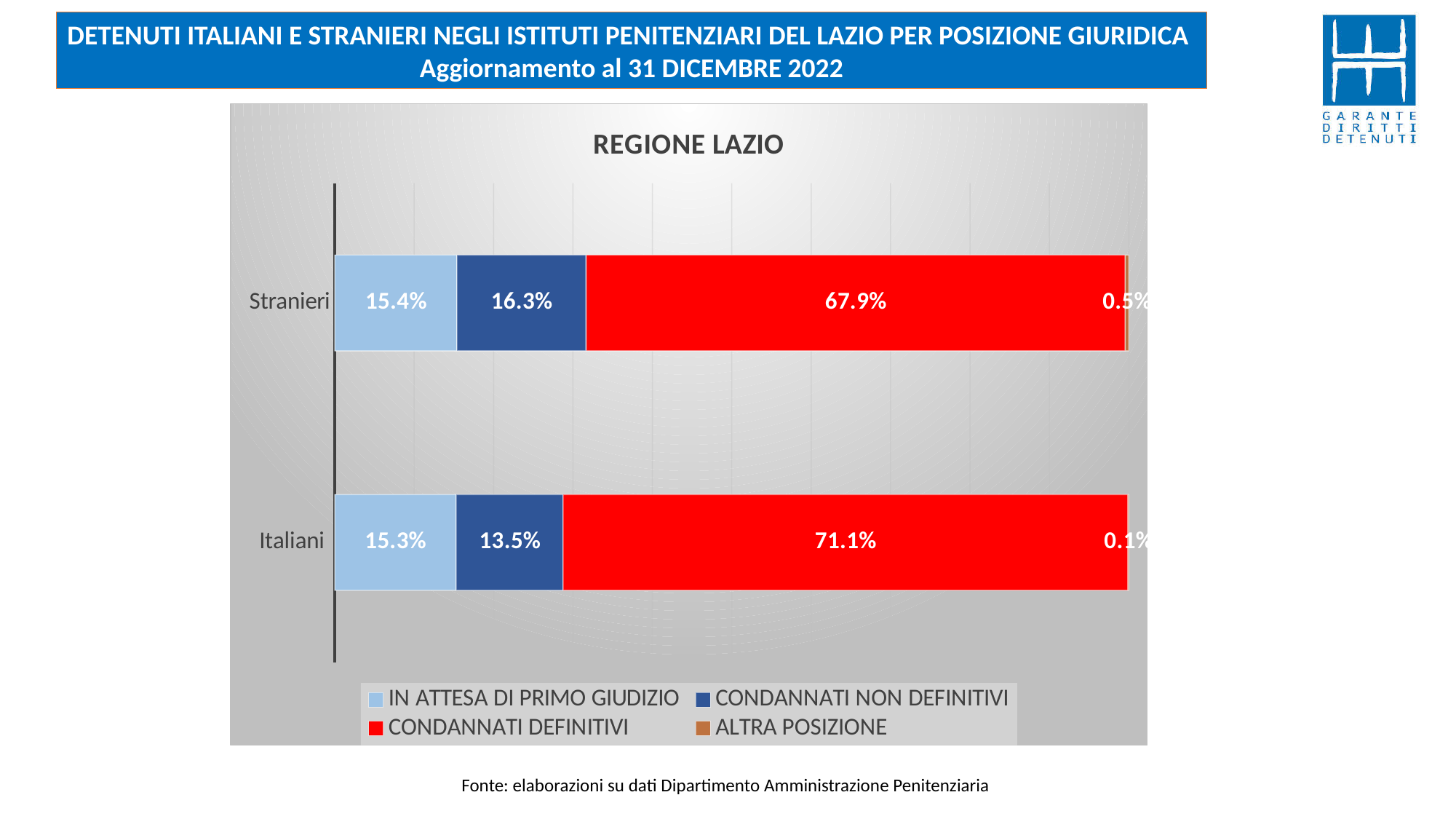
What percentage of Stranieri are CONDANNATI DEFINITIVI? 67.9% Which category has the higher share of CONDANNATI DEFINITIVI, Stranieri or Italiani? Italiani What percentage of Italiani are IN ATTESA DI PRIMO GIUDIZIO? 15.3% What kind of chart is shown on the slide? Stacked bar chart What is the difference between the CONDANNATI NON DEFINITIVI share for Stranieri and for Italiani? 2.8% Which series has the largest share for Italiani? CONDANNATI DEFINITIVI How many series does the legend list? 4 What is the difference between the CONDANNATI DEFINITIVI share for Italiani and for Stranieri? 3.2% Which category has the higher share of CONDANNATI NON DEFINITIVI, Stranieri or Italiani? Stranieri What percentage of Italiani are CONDANNATI NON DEFINITIVI? 13.5% Which series has the smallest share for Stranieri? ALTRA POSIZIONE What percentage of Stranieri are in ALTRA POSIZIONE? 0.5%